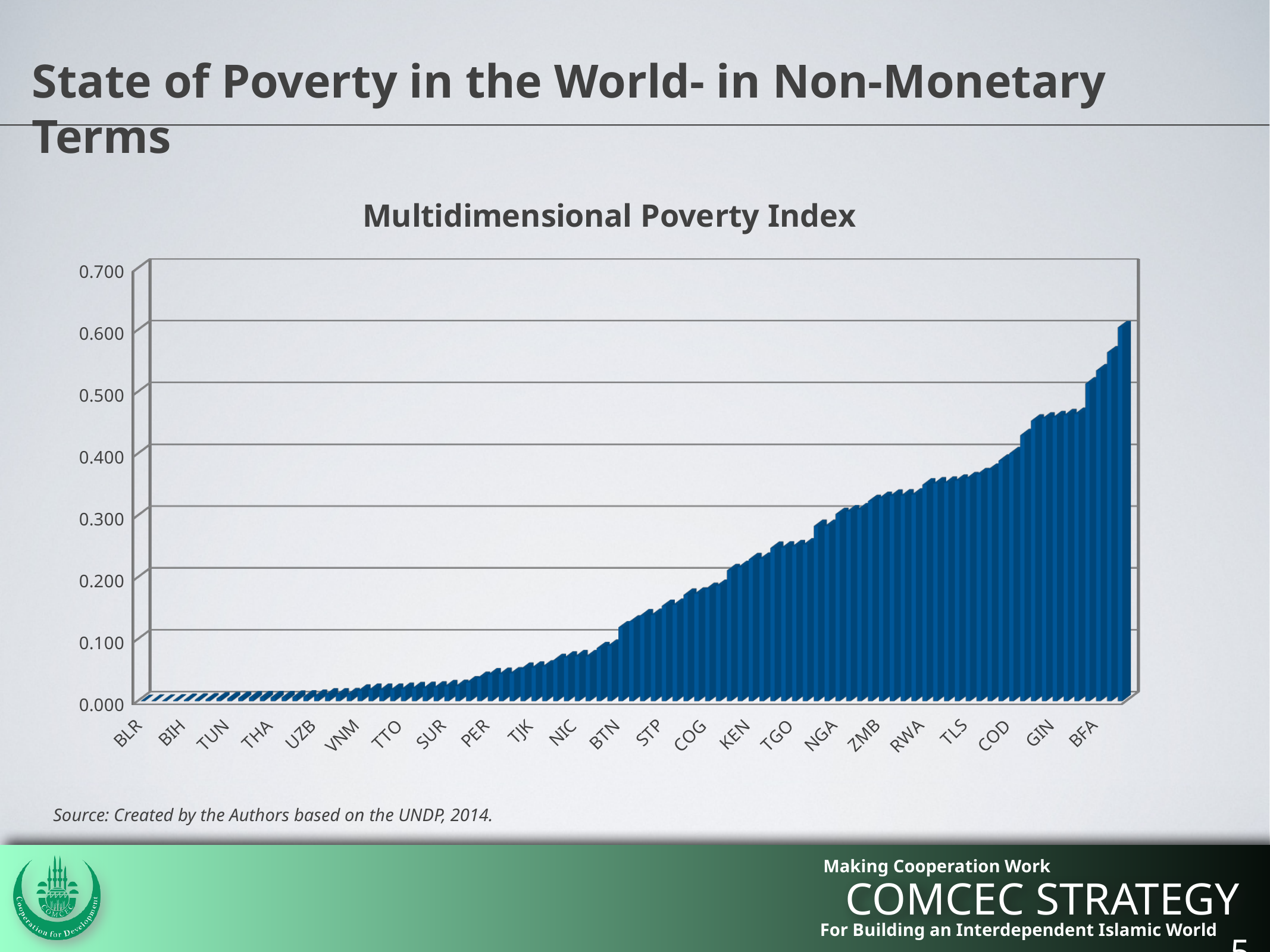
Is the value for GIN greater or less than 0.400? greater Is the value for KEN greater or less than 0.300? less What is the title of the chart? Multidimensional Poverty Index Which has the larger value, TUN or KEN? KEN Do the values generally rise or fall moving from left to right along the x axis? rise Is the value for BTN greater or less than 0.200? less Which has the larger value, BFA or BLR? BFA What kind of chart is shown on the slide? bar chart